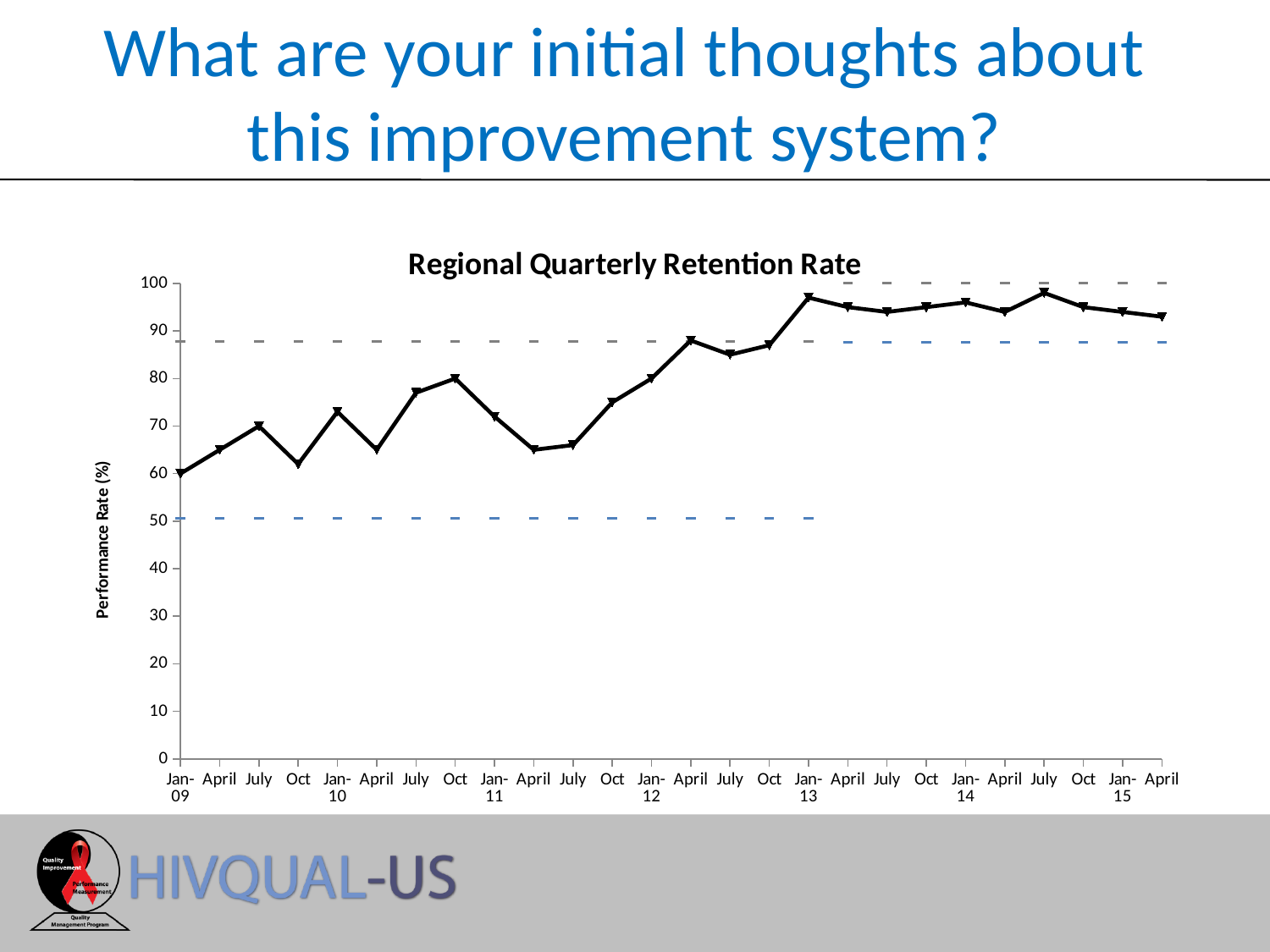
Is the value for April 2011 greater or less than 70? less How many quarterly data points are plotted on the chart? 26 Is the value for Jan-15 greater or less than 90? greater What is the performance rate for Jan-09? 60 What is the label on the vertical axis of the chart? Performance Rate (%) Is the value for April 2012 greater or less than 80? greater What kind of chart is shown on the slide? line chart Which is larger, the value for Oct 2010 or the value for Jan-11? Oct 2010 Overall, does the retention rate rise or fall from Jan-09 to April 2015? rise What is the title of the chart? Regional Quarterly Retention Rate What is the performance rate for Oct 2010? 80